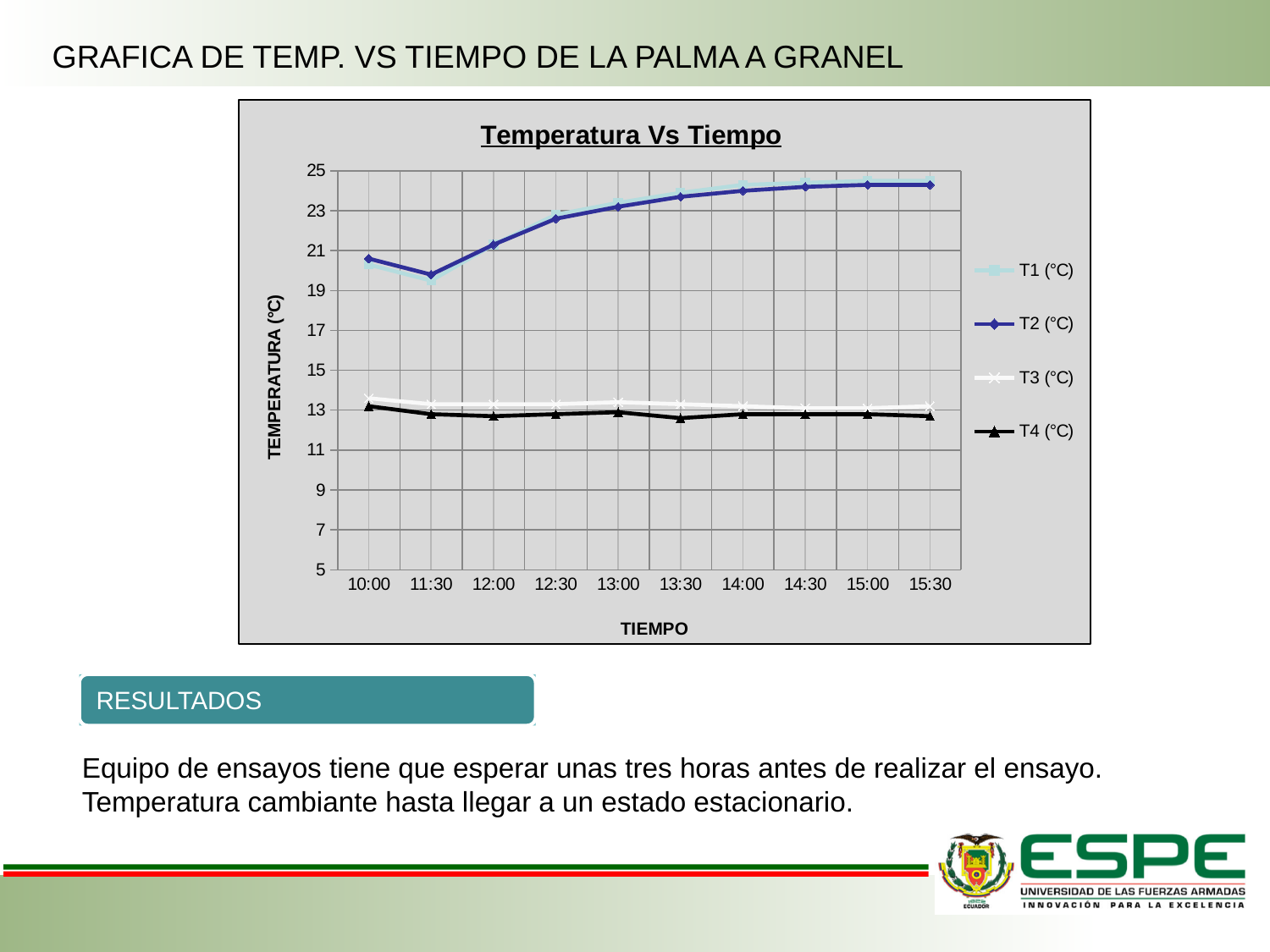
How many time points are plotted along the x axis? 10 At 14:00, which is larger, T2 (°C) or T4 (°C)? T2 (°C) Is the value for T2 (°C) at 12:30 greater or less than 21? greater Is the value for T2 (°C) at 11:30 greater or less than 21? less What kind of chart is shown on the slide? Line chart What is the label of the vertical axis? TEMPERATURA (°C) Is the value for T4 (°C) at 10:00 greater or less than 15? less How many series does the legend list? 4 At which time does the T2 (°C) series reach its lowest value? 11:30 What is the title of the chart? Temperatura Vs Tiempo Does the T2 (°C) series generally rise or fall from 11:30 to 15:30? Rise